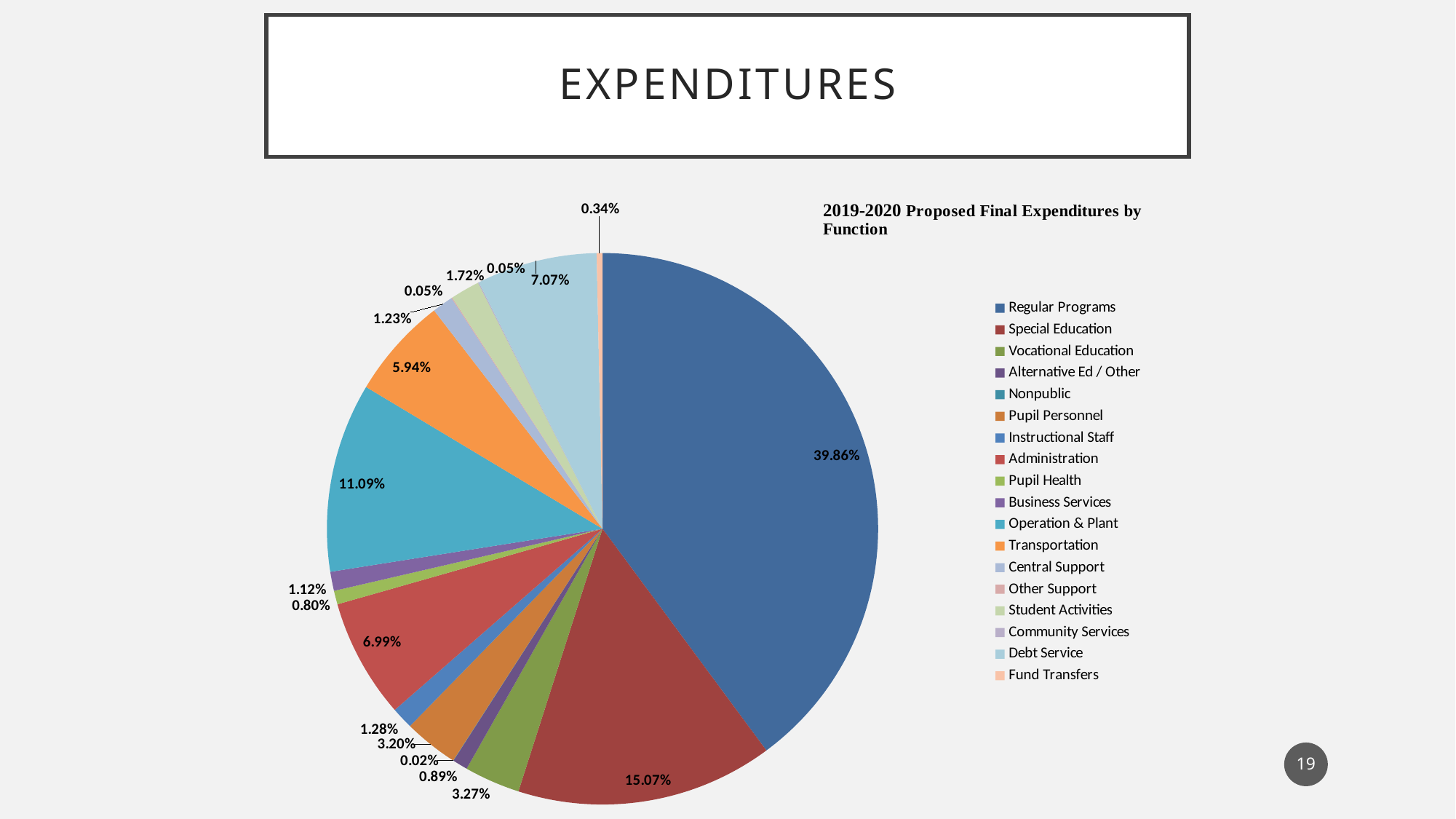
What percentage of expenditures is Operation & Plant? 11.09% What is the difference between the Regular Programs share and the Special Education share? 24.79% What is the combined share of Operation & Plant and Transportation? 17.03% What percentage of expenditures is Special Education? 15.07% What type of chart is shown on the slide? pie chart Which is larger, the Administration share or the Debt Service share? Debt Service What is the title of the chart? 2019-2020 Proposed Final Expenditures by Function How many entries does the legend list? 18 What percentage of expenditures is Debt Service? 7.07% What percentage of expenditures is Regular Programs? 39.86% Which function has the largest share of expenditures? Regular Programs What percentage of expenditures is Transportation? 5.94%